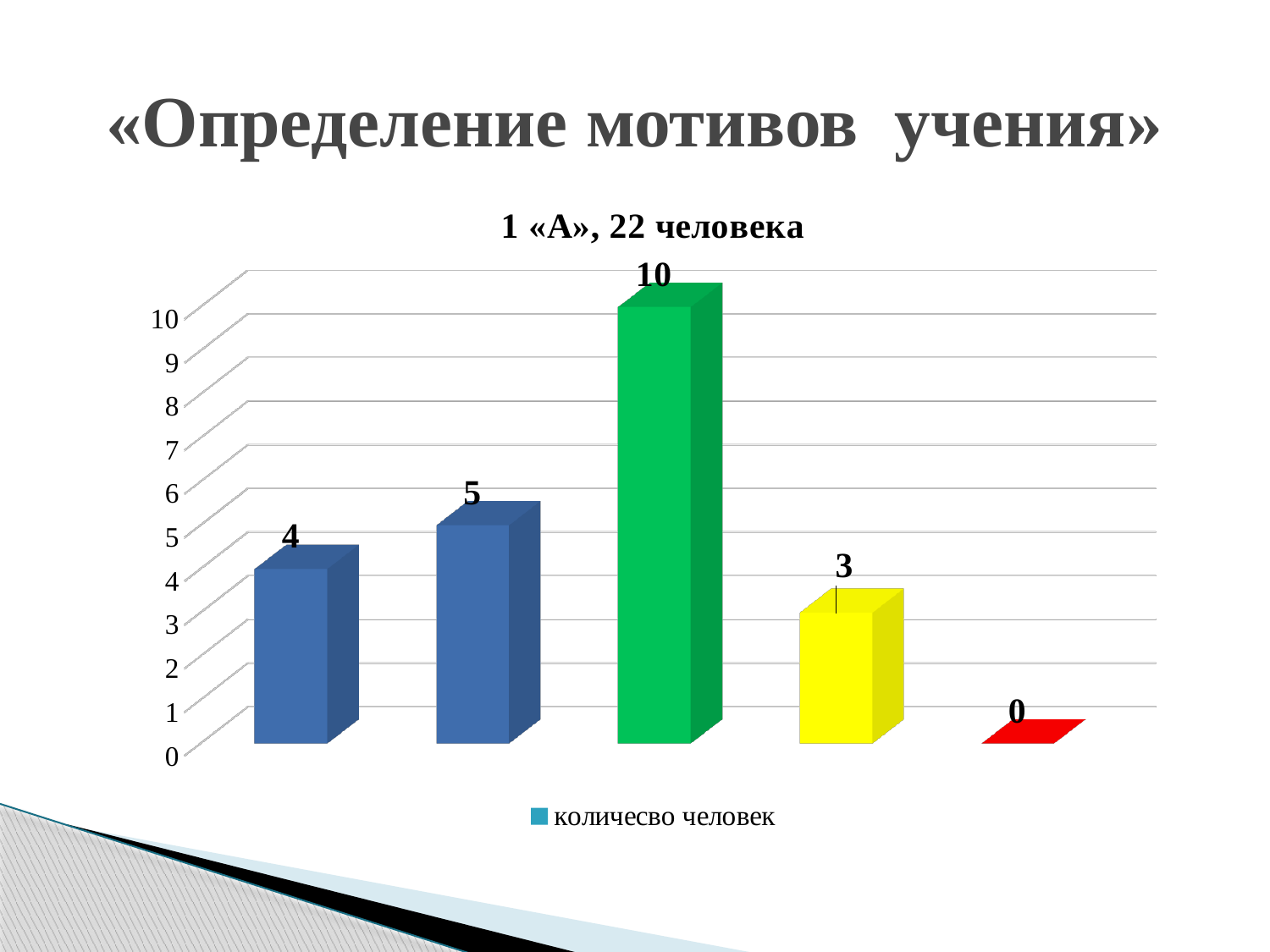
What type of chart is shown on the slide? bar chart What is the value of the red bar (rightmost)? 0 What is the value of the green bar? 10 Which bar has the lowest value? the red bar (rightmost), 0 What is the value of the second bar from the left? 5 How many bars are plotted in the chart? 5 What is the value of the yellow bar? 3 What is the title of the chart? 1 «А», 22 человека What is the value of the first (leftmost) bar? 4 What is the legend entry shown below the chart? количесво человек Which bar has the highest value? the green bar (third from left), 10 What is the difference between the green bar and the yellow bar? 7